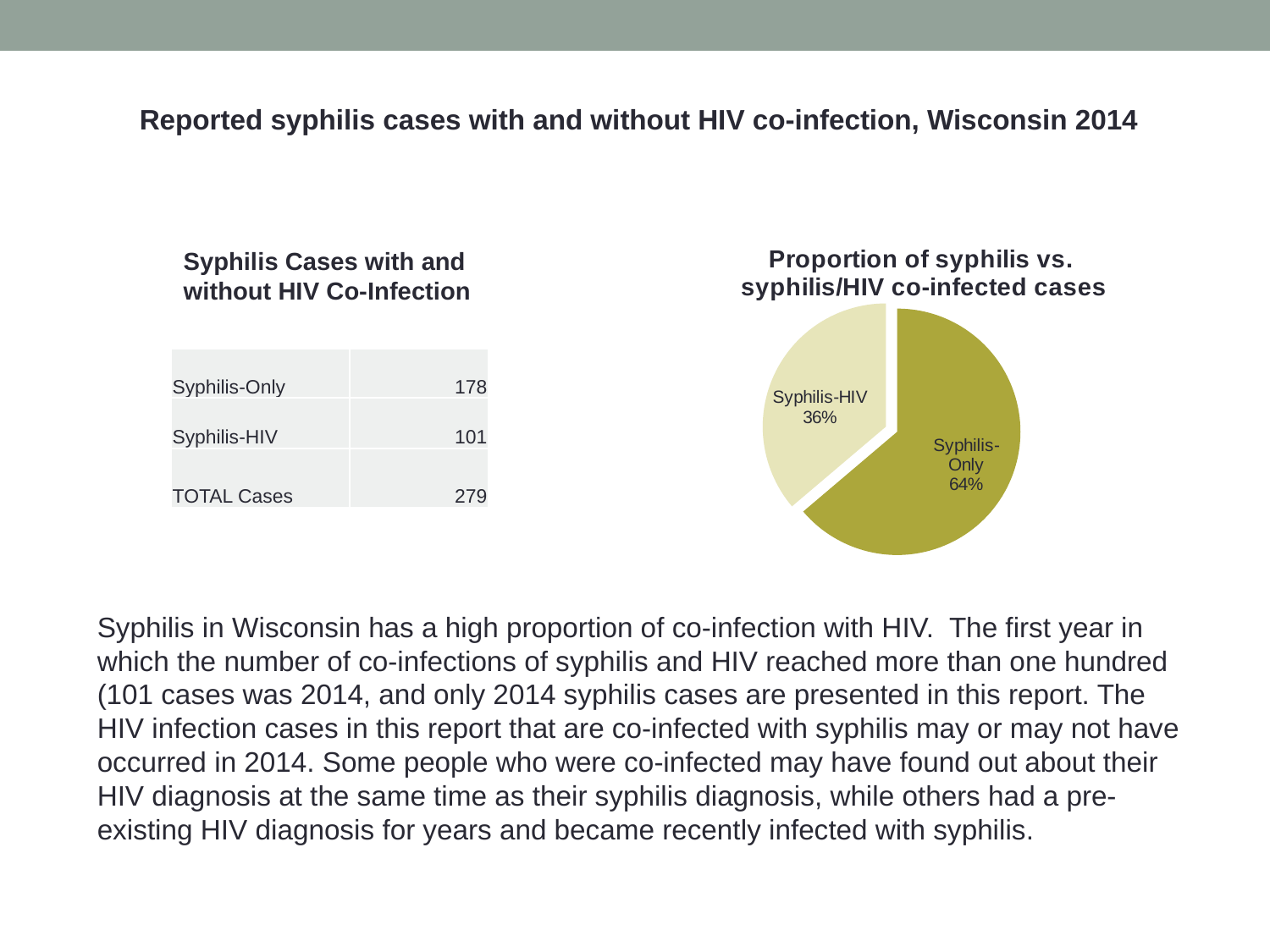
What type of chart is shown on the right side of the slide? pie chart In the table 'Syphilis Cases with and without HIV Co-Infection', how many Syphilis-Only cases are listed? 178 In the pie chart, which slice is the smallest? Syphilis-HIV In the pie chart, is the Syphilis-HIV slice larger or smaller than the Syphilis-Only slice? smaller How many slices does the pie chart have? 2 What is the title of the pie chart on the slide? Proportion of syphilis vs. syphilis/HIV co-infected cases In the pie chart 'Proportion of syphilis vs. syphilis/HIV co-infected cases', what share is Syphilis-HIV? 36% In the table 'Syphilis Cases with and without HIV Co-Infection', how many Syphilis-HIV cases are listed? 101 In the pie chart 'Proportion of syphilis vs. syphilis/HIV co-infected cases', what share is Syphilis-Only? 64% In the pie chart, which slice is the largest? Syphilis-Only In the table 'Syphilis Cases with and without HIV Co-Infection', what is the TOTAL Cases value? 279 In the pie chart, what is the difference in percentage points between the Syphilis-Only and Syphilis-HIV slices? 28